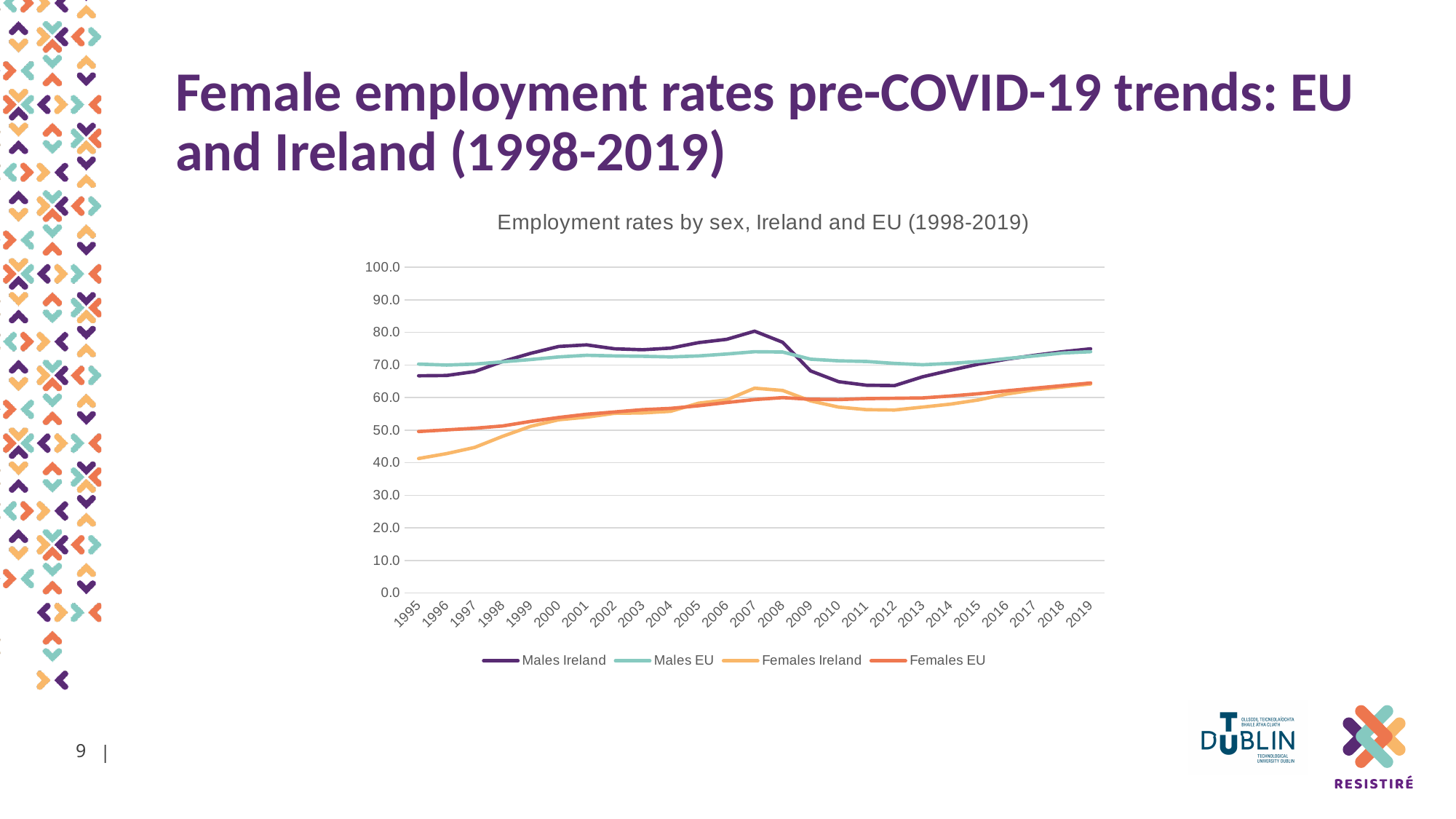
Is the value for Females Ireland in 1995 greater or less than 50? less Is the value for Males Ireland in 2007 greater or less than 70? greater Which series has the highest value in 2007? Males Ireland Which series is drawn in dark purple? Males Ireland Is the value for Males Ireland in 2012 greater or less than 70? less How many series does the legend list? 4 In 2012, which is larger: Males Ireland or Males EU? Males EU Does the Females Ireland line rise or fall from 1995 to 2007? rise How many years are plotted along the x axis? 25 What is the title of the chart? Employment rates by sex, Ireland and EU (1998-2019) Which series has the lowest value in 1995? Females Ireland What kind of chart is shown on the slide? line chart